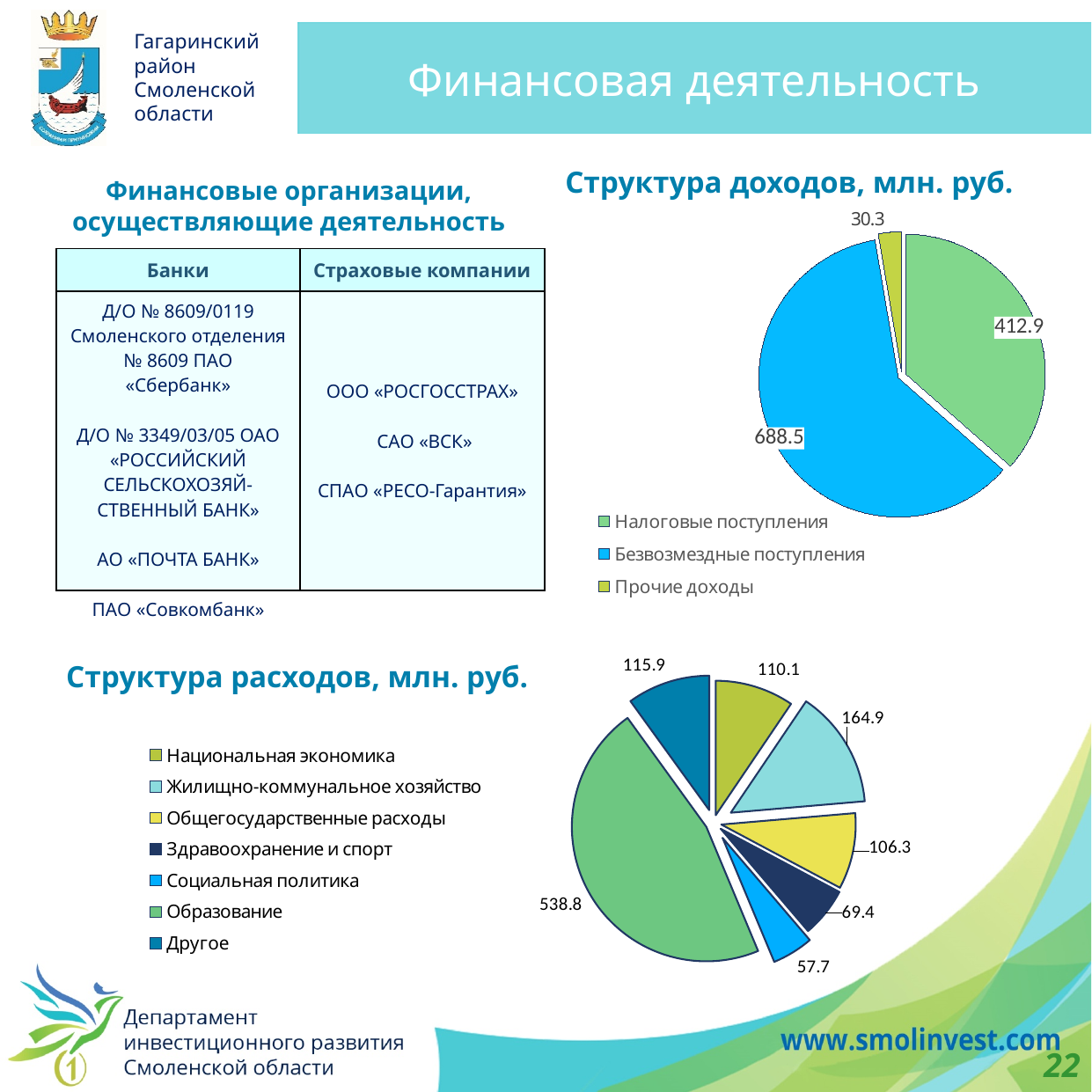
In the chart 'Структура расходов, млн. руб.', what is the difference between Другое and Здравоохранение и спорт? 46.5 In the chart 'Структура расходов, млн. руб.', what is the value for Жилищно-коммунальное хозяйство? 164.9 In the chart 'Структура расходов, млн. руб.', which category has the lowest value? Социальная политика In the chart 'Структура расходов, млн. руб.', what is the value for Образование? 538.8 In the chart 'Структура доходов, млн. руб.', what is the value for Налоговые поступления? 412.9 In the chart 'Структура доходов, млн. руб.', which category has the smallest value? Прочие доходы In the chart 'Структура доходов, млн. руб.', what is the difference between Безвозмездные поступления and Налоговые поступления? 275.6 In the chart 'Структура доходов, млн. руб.', how many categories does the legend list? 3 What type of chart is used for 'Структура доходов, млн. руб.'? Pie chart In the chart 'Структура расходов, млн. руб.', which is larger: Национальная экономика or Общегосударственные расходы? Национальная экономика In the chart 'Структура расходов, млн. руб.', how many categories does the legend list? 7 In the chart 'Структура доходов, млн. руб.', what is the value for Безвозмездные поступления? 688.5